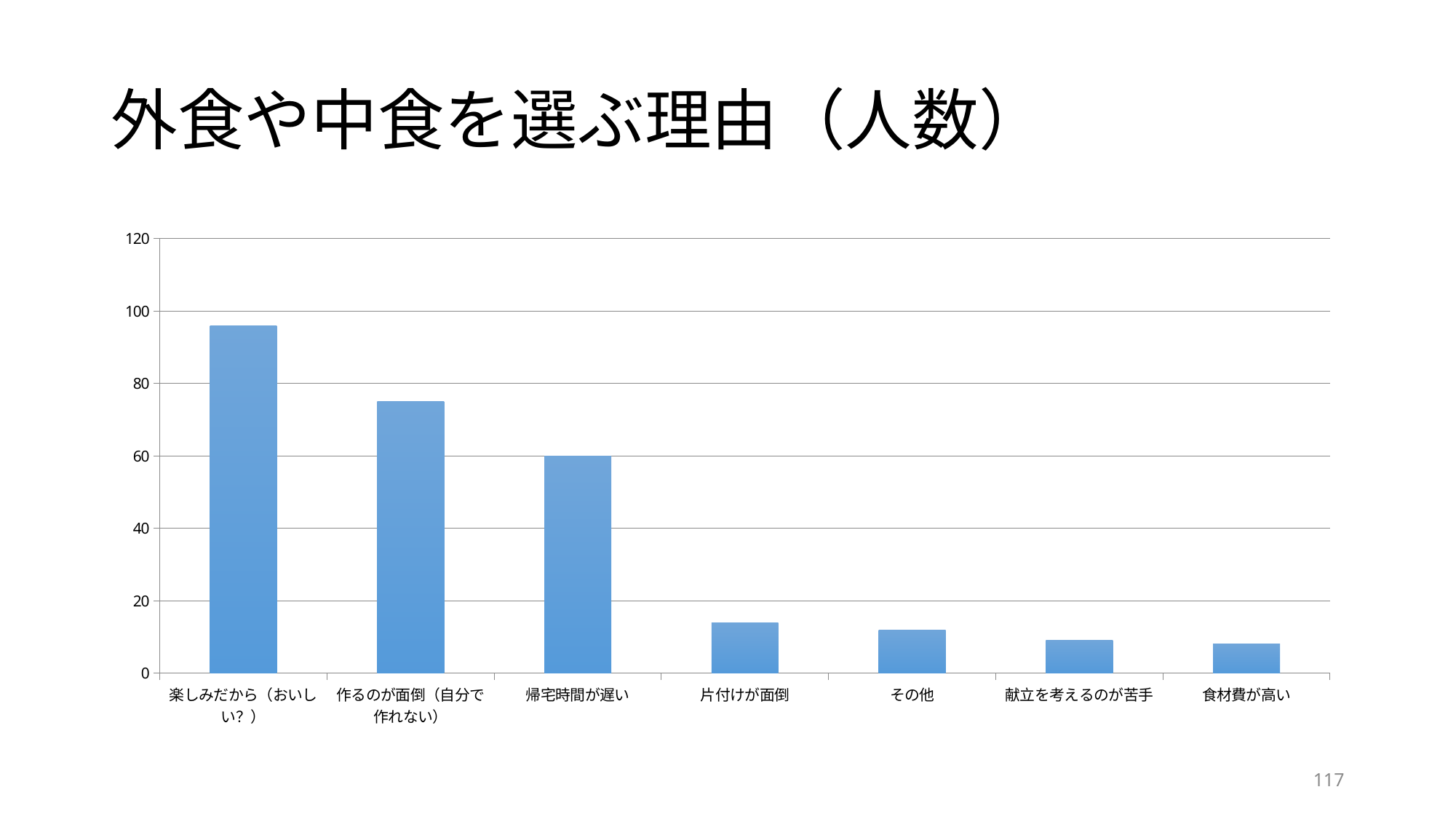
What is the title of the slide containing the chart? 外食や中食を選ぶ理由（人数） Is the value for 楽しみだから（おいしい？） greater or less than 80? greater Is the value for 作るのが面倒（自分で作れない） greater or less than 80? less Is the value for 献立を考えるのが苦手 greater or less than 20? less How many categories are plotted in the chart? 7 Do the values rise or fall from left to right across the categories? fall Which is larger, the value for 作るのが面倒（自分で作れない） or the value for 帰宅時間が遅い? 作るのが面倒（自分で作れない） Which category has the highest value? 楽しみだから（おいしい？） What kind of chart is shown on the slide? bar chart Which category has the lowest value? 食材費が高い What is the value for 帰宅時間が遅い? 60